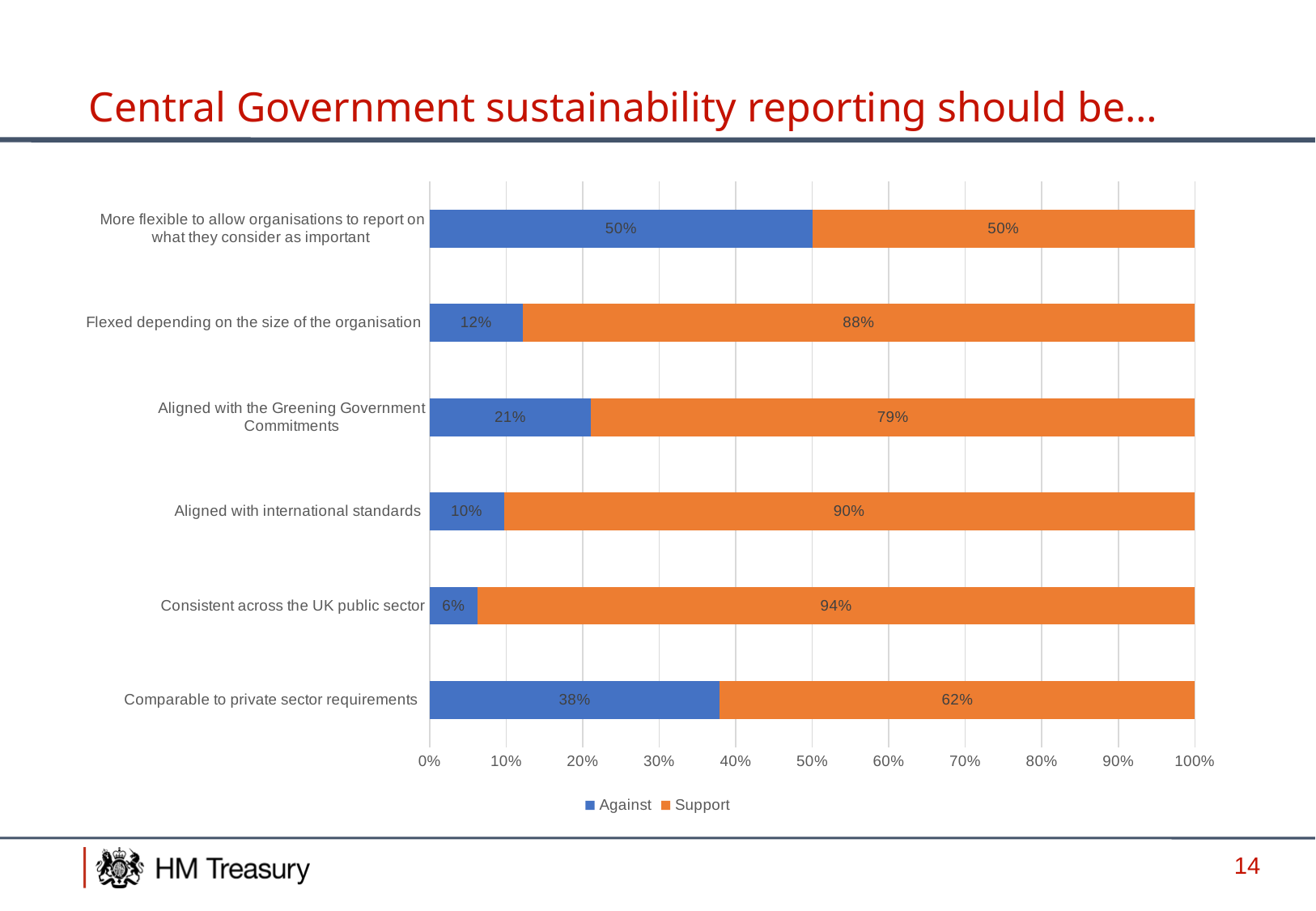
Which option has the lowest Against percentage? Consistent across the UK public sector What is the difference between the Support and Against percentages for 'Aligned with the Greening Government Commitments'? 58% Which option has the highest Support percentage? Consistent across the UK public sector Is the Against percentage larger for 'Aligned with international standards' or for 'Comparable to private sector requirements'? Comparable to private sector requirements What type of chart is shown on the slide? Stacked bar chart What is the Support value for 'Flexed depending on the size of the organisation'? 88% How many options are listed on the chart? 6 What percentage of respondents are against reporting being comparable to private sector requirements? 38% Which colour represents the Support series? Orange What percentage of respondents support reporting being consistent across the UK public sector? 94% Which option has the highest Against percentage? More flexible to allow organisations to report on what they consider as important How many series does the legend list? 2